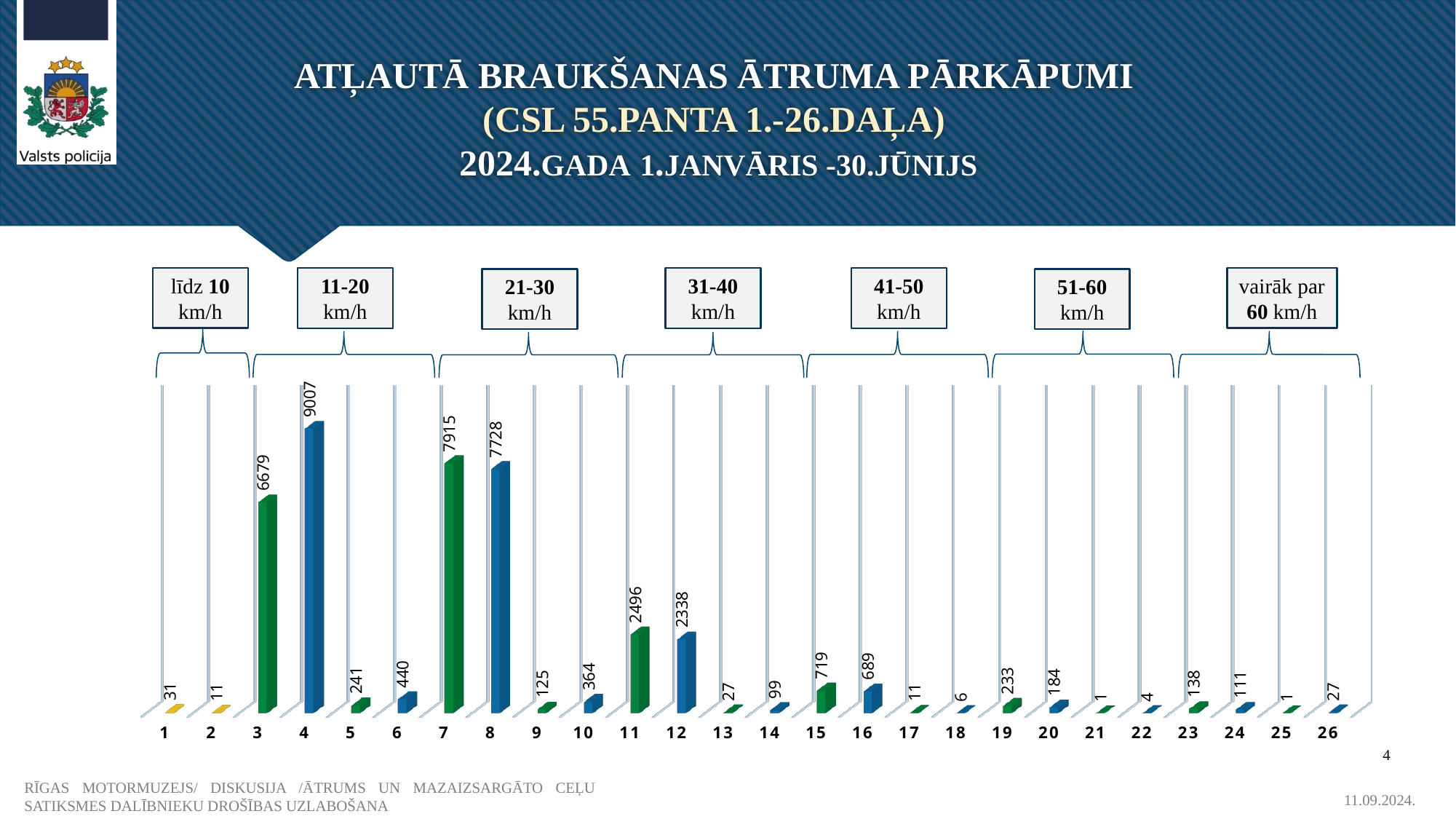
What is the value for category 4? 9007 How many categories are plotted along the x axis of the chart? 26 Which speed range label is shown above categories 11 to 14? 31-40 km/h What is the difference between the values for category 3 and category 4? 2328 What type of chart is shown on the slide? bar chart What is the difference between the values for category 7 and category 8? 187 Which has a larger value, category 5 or category 6? category 6 What is the value for category 19? 233 What is the value for category 7? 7915 What is the value for category 12? 2338 Which category has the highest value in the chart? 4 Which has a larger value, category 15 or category 16? category 15